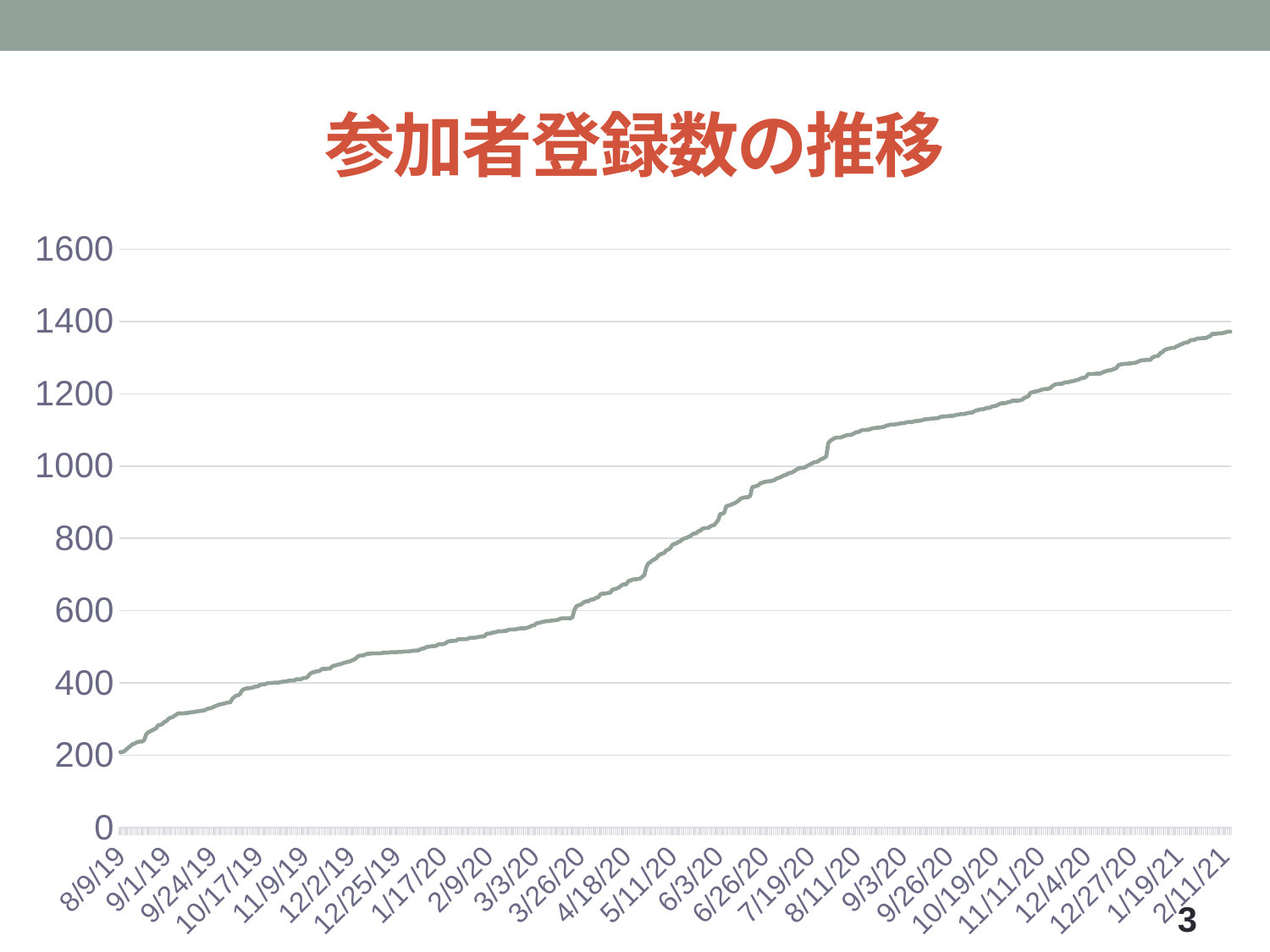
Is the value at 8/9/19 greater or less than 400? less Do the values rise or fall along the x axis from 8/9/19 to 2/11/21? rise At which date on the x axis is the plotted value highest? 2/11/21 Is the value at 2/11/21 greater or less than 1200? greater Is the value at 2/11/21 greater or less than 1400? less What is the title of the chart? 参加者登録数の推移 Which is larger, the value at 2/11/21 or the value at 8/9/19? 2/11/21 At which date on the x axis is the plotted value lowest? 8/9/19 What is the highest value shown on the y axis? 1600 What kind of chart is shown on the slide? line chart